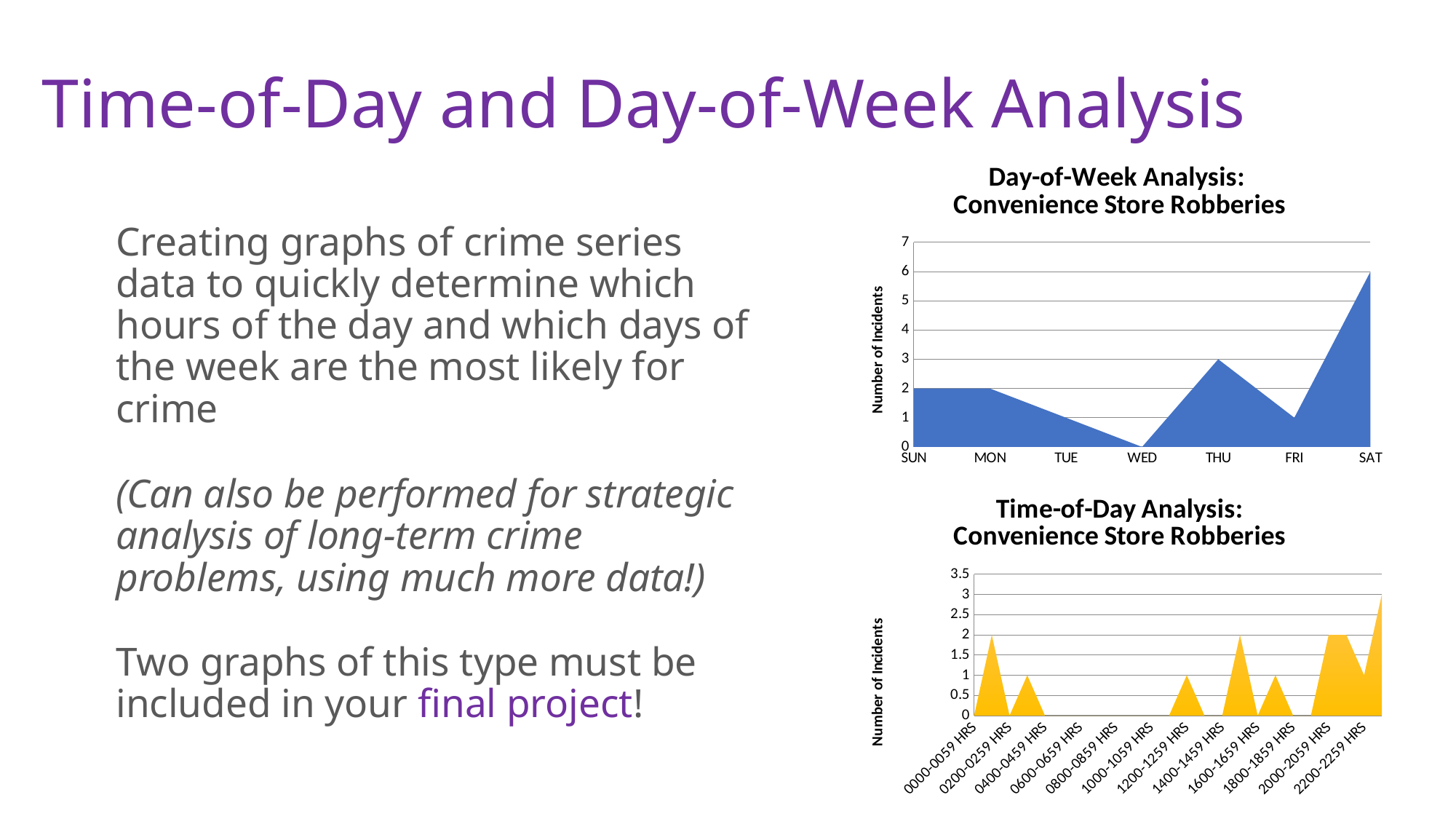
In the Day-of-Week Analysis chart, which day has the lowest number of incidents? WED What kind of chart is the Day-of-Week Analysis chart? Area chart In the Day-of-Week Analysis chart, what is the difference in incidents between SAT and THU? 3 In the Day-of-Week Analysis chart, how many incidents are shown for SAT? 6 In the Day-of-Week Analysis chart, is the value for SAT greater or less than 5? greater In the Day-of-Week Analysis chart, which day has the highest number of incidents? SAT In the Day-of-Week Analysis chart, how many incidents are shown for SUN? 2 In the Day-of-Week Analysis chart, which day has more incidents, THU or FRI? THU In the Day-of-Week Analysis chart, how many incidents are shown for THU? 3 How many days are plotted along the x axis of the Day-of-Week Analysis chart? 7 In the Time-of-Day Analysis chart, what is the highest number of incidents reached? 3